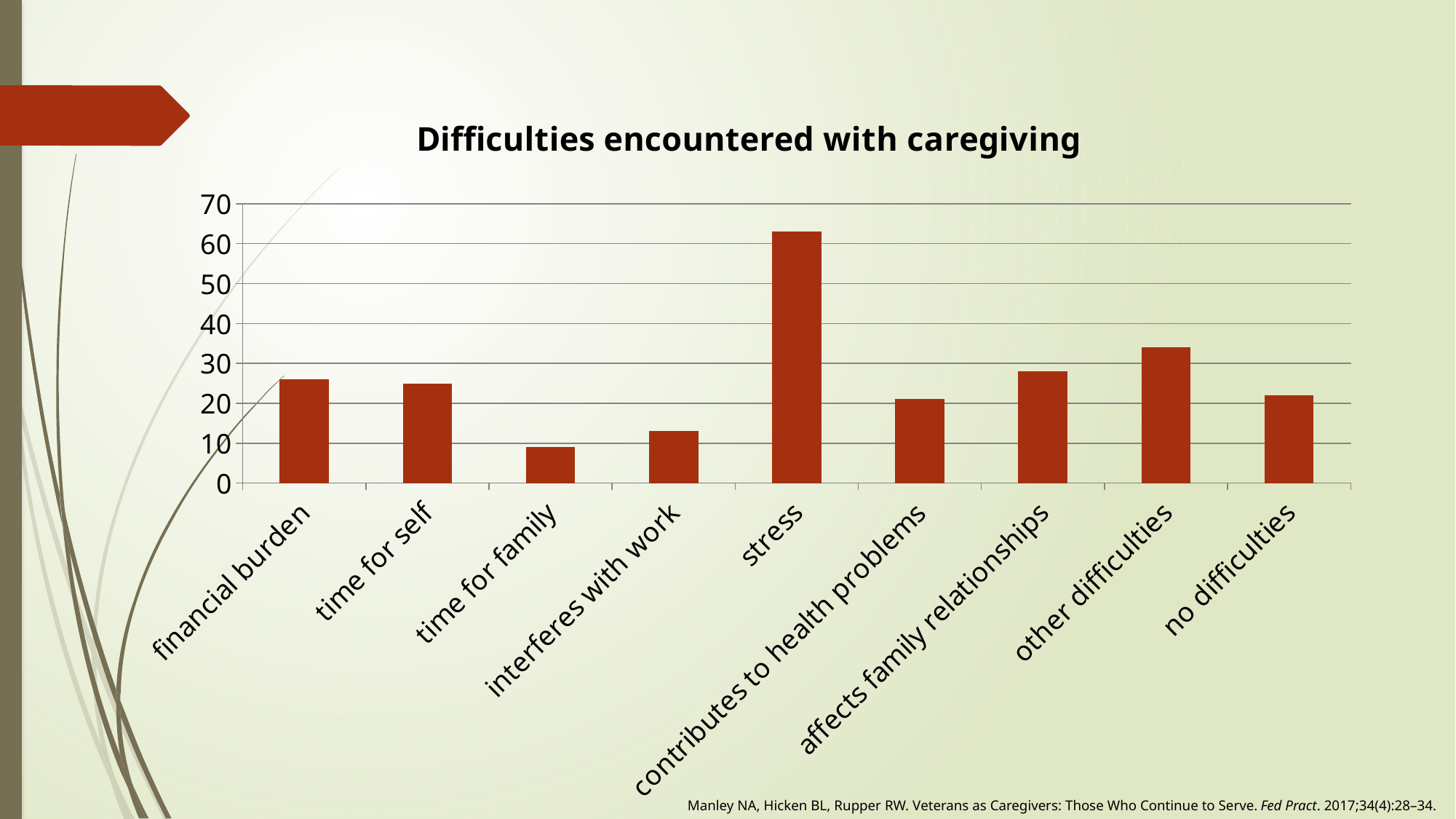
Which category has the highest value? stress Is the value for financial burden greater or less than 20? greater Is the value for stress greater or less than 60? greater Which is larger, the value for interferes with work or the value for affects family relationships? affects family relationships Which category has the lowest value? time for family What kind of chart is shown on the slide? bar chart Is the value for other difficulties greater or less than 30? greater How many categories are shown on the x axis of the chart? 9 What is the title of the chart? Difficulties encountered with caregiving Which is larger, the value for other difficulties or the value for no difficulties? other difficulties